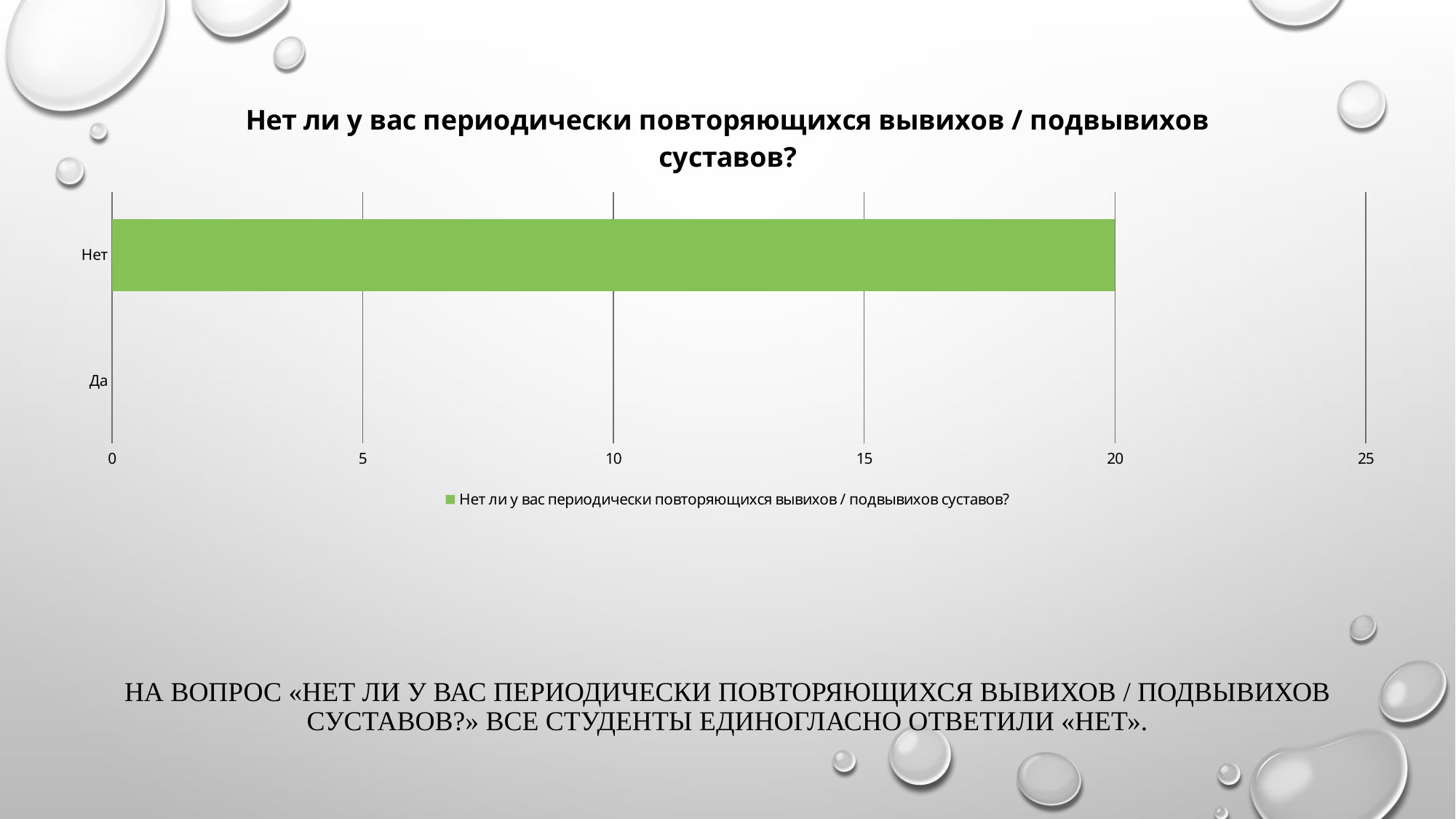
Which category has the highest value? Нет How many categories are shown on the vertical axis of the chart? 2 What is the value for the category "Нет"? 20 Which category has the larger value, "Нет" or "Да"? Нет What is the value for the category "Да"? 0 Which category has the lowest value? Да What colour is the bar in the chart? green Is the value for "Нет" greater or less than 15? greater How many series does the legend list? 1 What is the difference between the values for "Нет" and "Да"? 20 What is the title of the chart? Нет ли у вас периодически повторяющихся вывихов / подвывихов суставов? What kind of chart is shown on the slide? bar chart